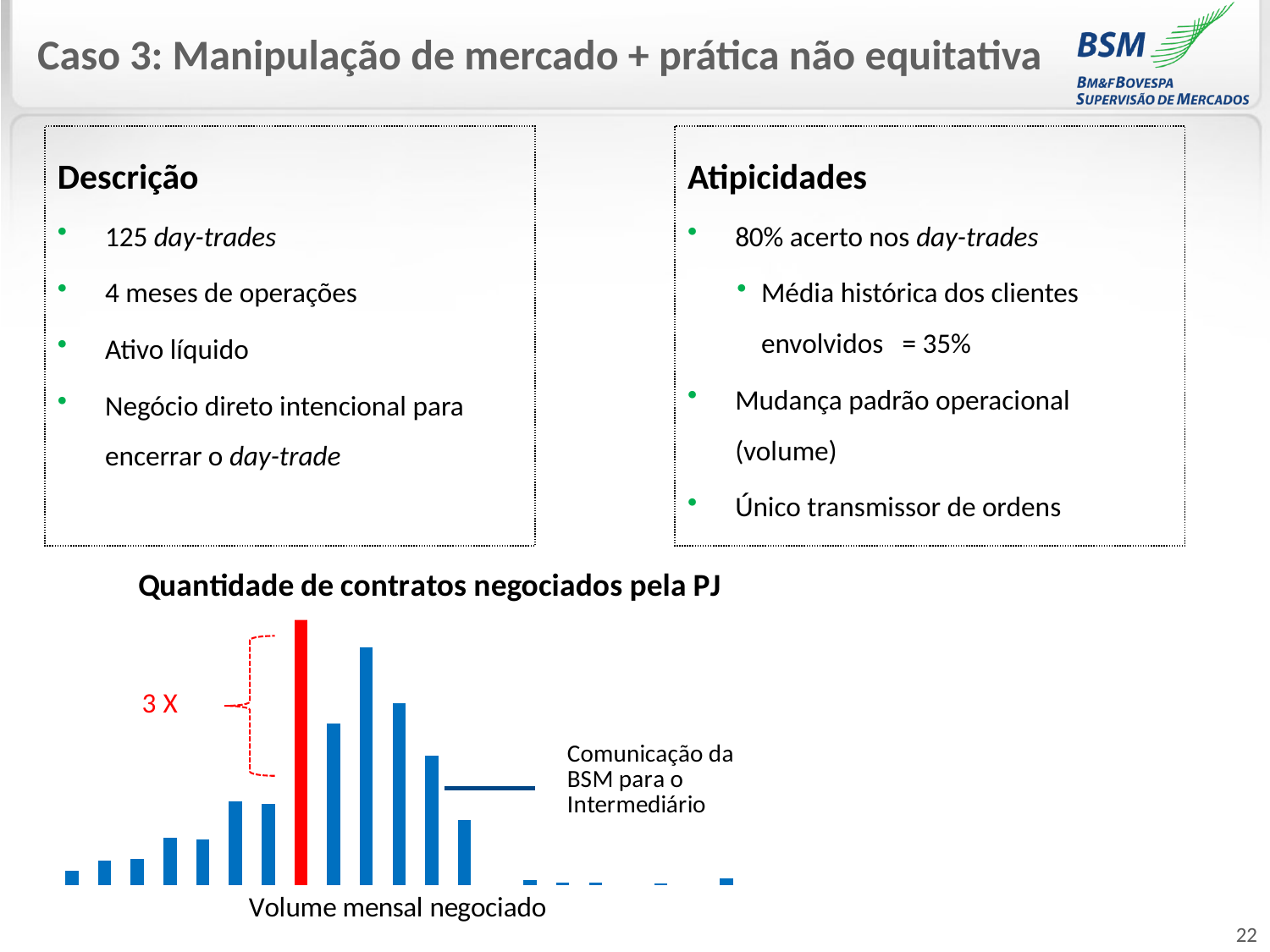
Is the red bar taller or shorter than the bar immediately to its right? taller Do the bars generally rise or fall moving left to right before the red bar? rise What label appears below the x axis of the chart? Volume mensal negociado What kind of chart is shown at the bottom of the slide? bar chart What is the title of the chart on the slide? Quantidade de contratos negociados pela PJ Which bar in the chart is the tallest? the red bar Do the bars generally rise or fall moving left to right after the red bar? fall How many bars are plotted to the left of the red bar? 7